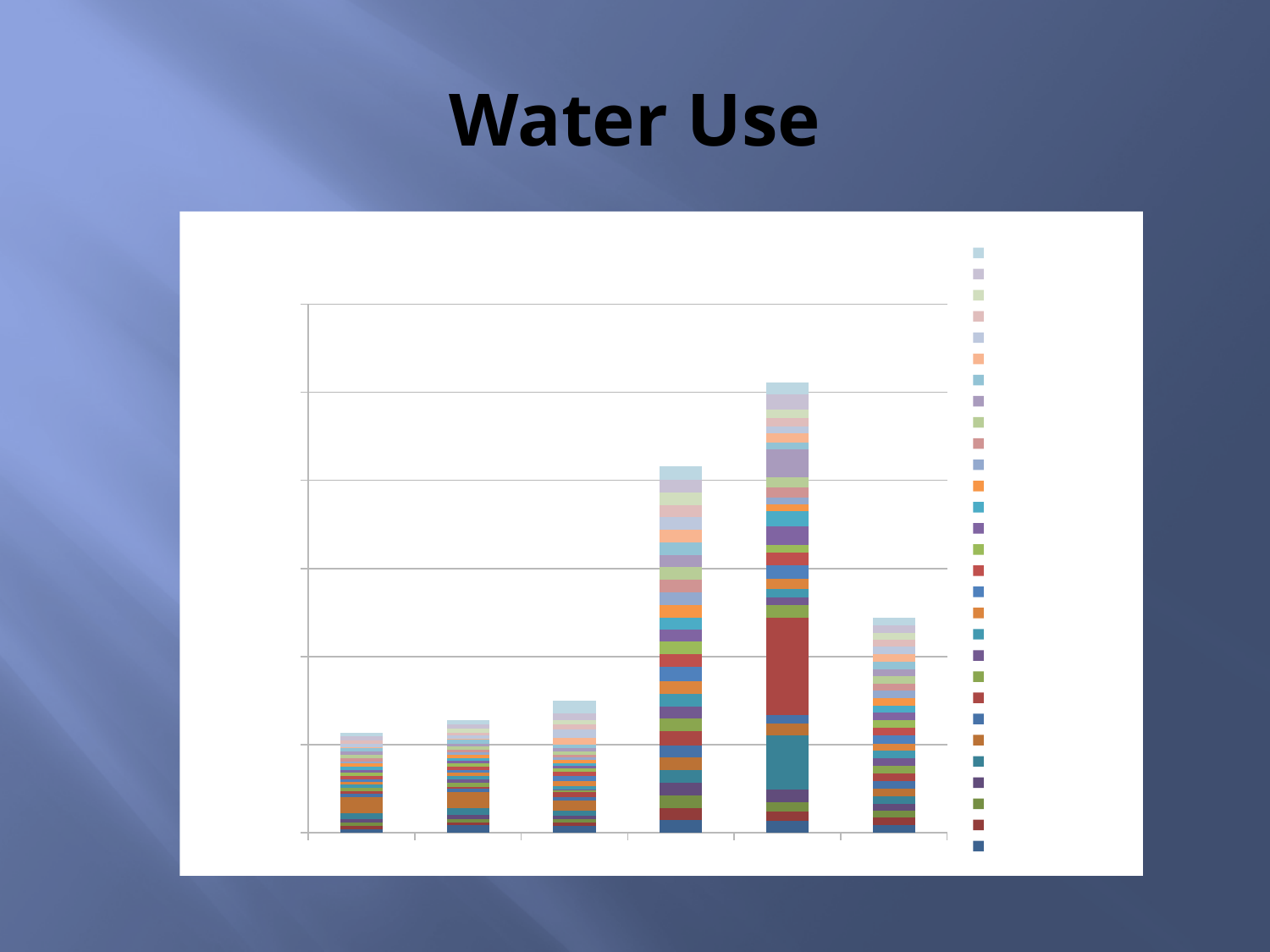
Does the vertical axis of the chart display numeric tick labels? No What kind of chart is shown on the slide? Stacked bar chart Which bar is the tallest in the chart? The fifth bar from the left How many bars (categories) are plotted in the chart? 6 Does the bar total rise or fall from the fifth bar to the sixth bar? Fall Which is taller, the first bar or the fourth bar from the left? The fourth bar Which is taller, the fourth bar or the fifth bar from the left? The fifth bar What is the title shown above the chart on the slide? Water Use Which is taller, the fourth bar or the sixth bar from the left? The fourth bar Do the bar totals rise or fall from the first bar to the fifth bar? Rise